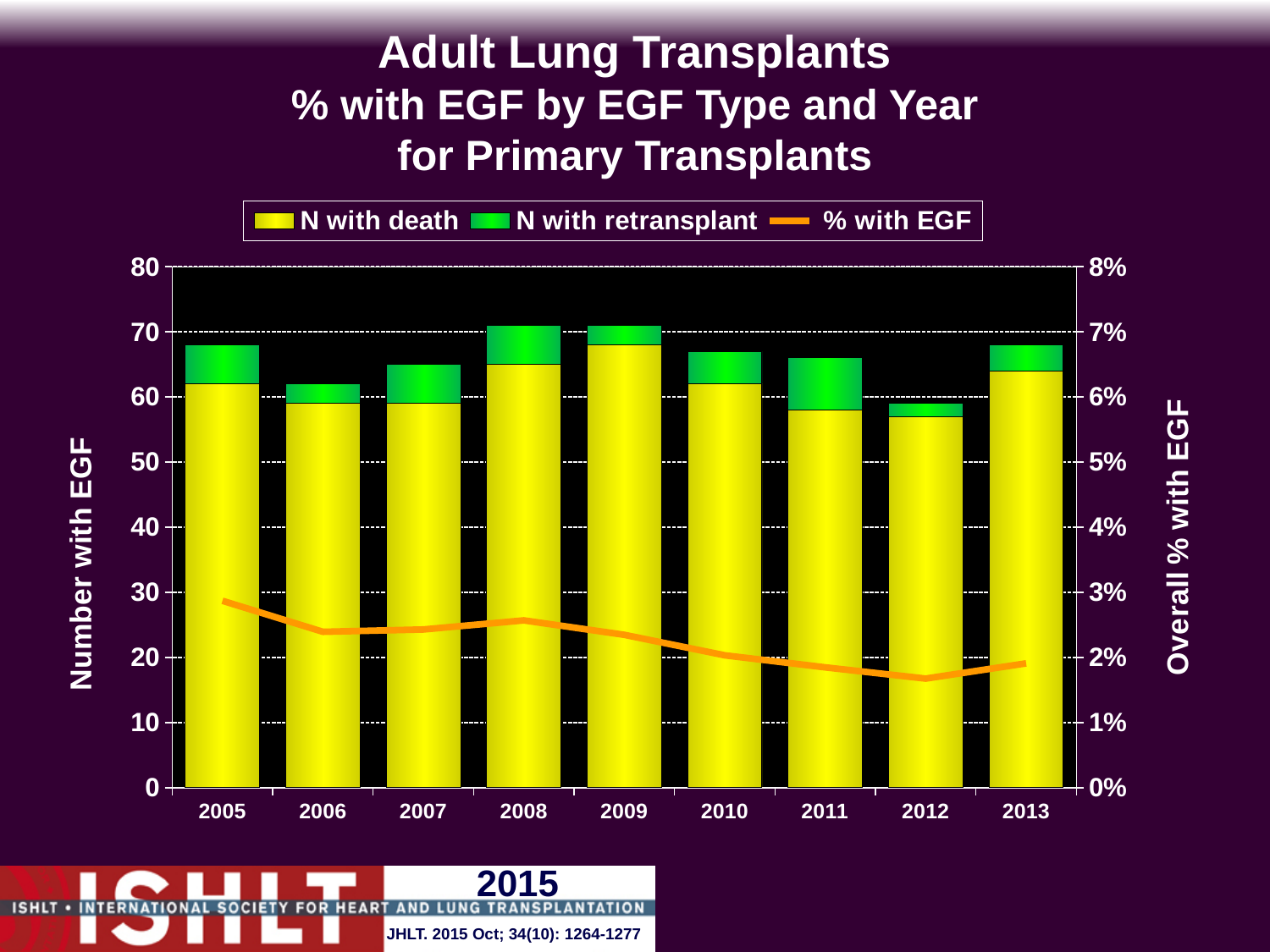
Is the % with EGF value for 2012 greater or less than 2%? less Which year has the highest % with EGF line value? 2005 Which year has the lowest % with EGF line value? 2012 Is the % with EGF value for 2005 greater or less than 2%? greater Which colour represents 'N with retransplant' in the chart? Green Does the % with EGF line generally rise or fall from 2005 to 2012? fall Is the total bar height (Number with EGF) for 2005 greater or less than 60? greater What kind of chart is shown on the slide? A stacked bar chart with a line Which year has the larger total Number with EGF bar, 2008 or 2012? 2008 How many series does the legend list? 3 How many years are shown on the x axis of the chart? 9